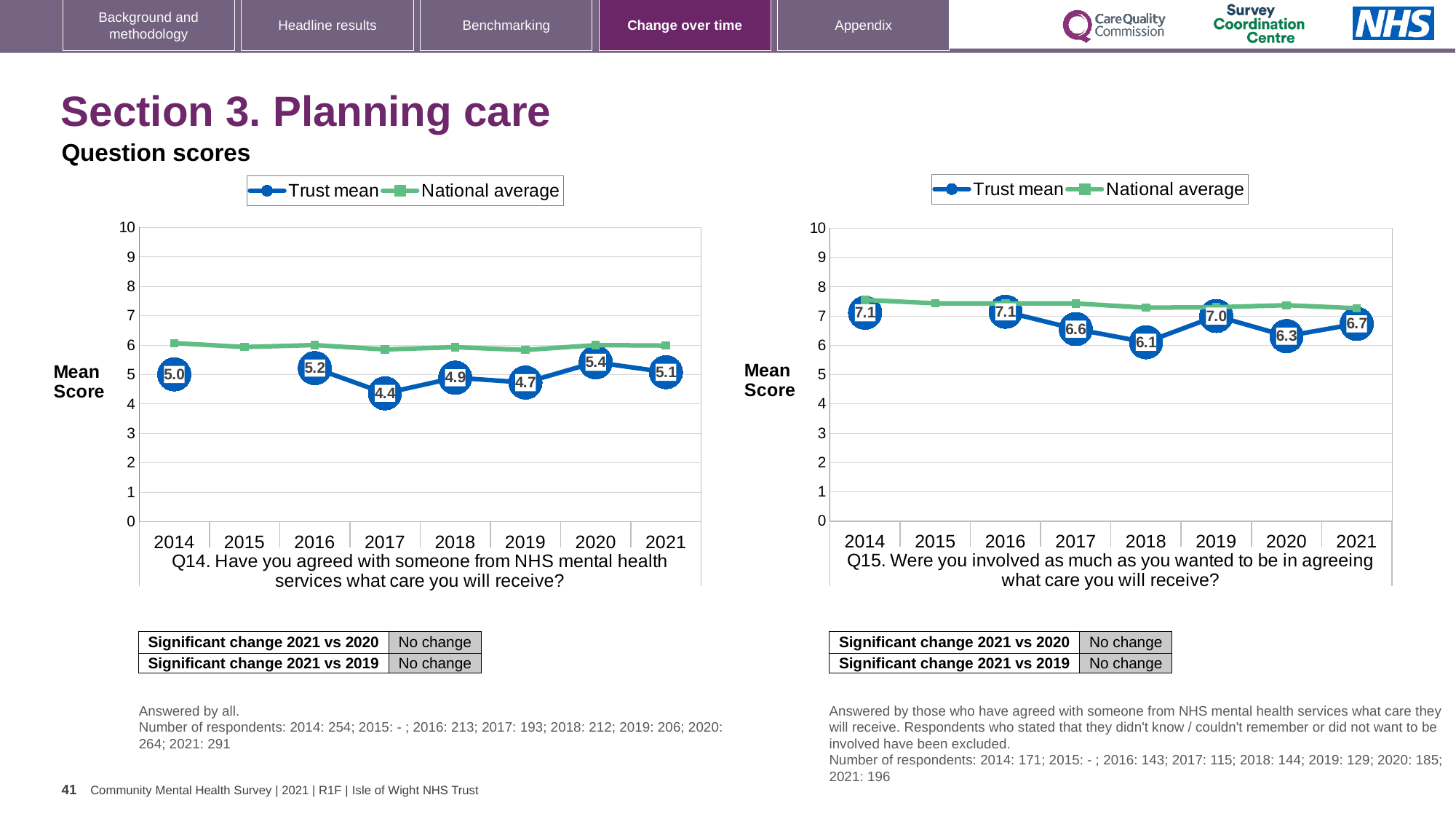
In the Q14 chart on the left, which year has the lowest Trust mean score? 2017 In the Q15 chart on the right, which year has the lowest Trust mean score? 2018 In the Q15 chart on the right, is the Trust mean score for 2019 larger than the Trust mean score for 2020? Yes In the Q14 chart on the left, which year has the highest Trust mean score? 2020 What kind of chart is the Q14 chart on the left? Line chart In the Q15 chart on the right, what is the Trust mean score for 2018? 6.1 How many series does the legend of the Q15 chart on the right list? 2 In the Q14 chart on the left, what is the Trust mean score for 2017? 4.4 In the Q14 chart on the left, what is the Trust mean score for 2021? 5.1 In the Q15 chart on the right, what is the difference between the Trust mean scores for 2021 and 2020? 0.4 In the Q14 chart on the left, what is the difference between the Trust mean scores for 2020 and 2017? 1.0 In the Q14 chart on the left, is the National average for 2021 greater or less than 5? greater